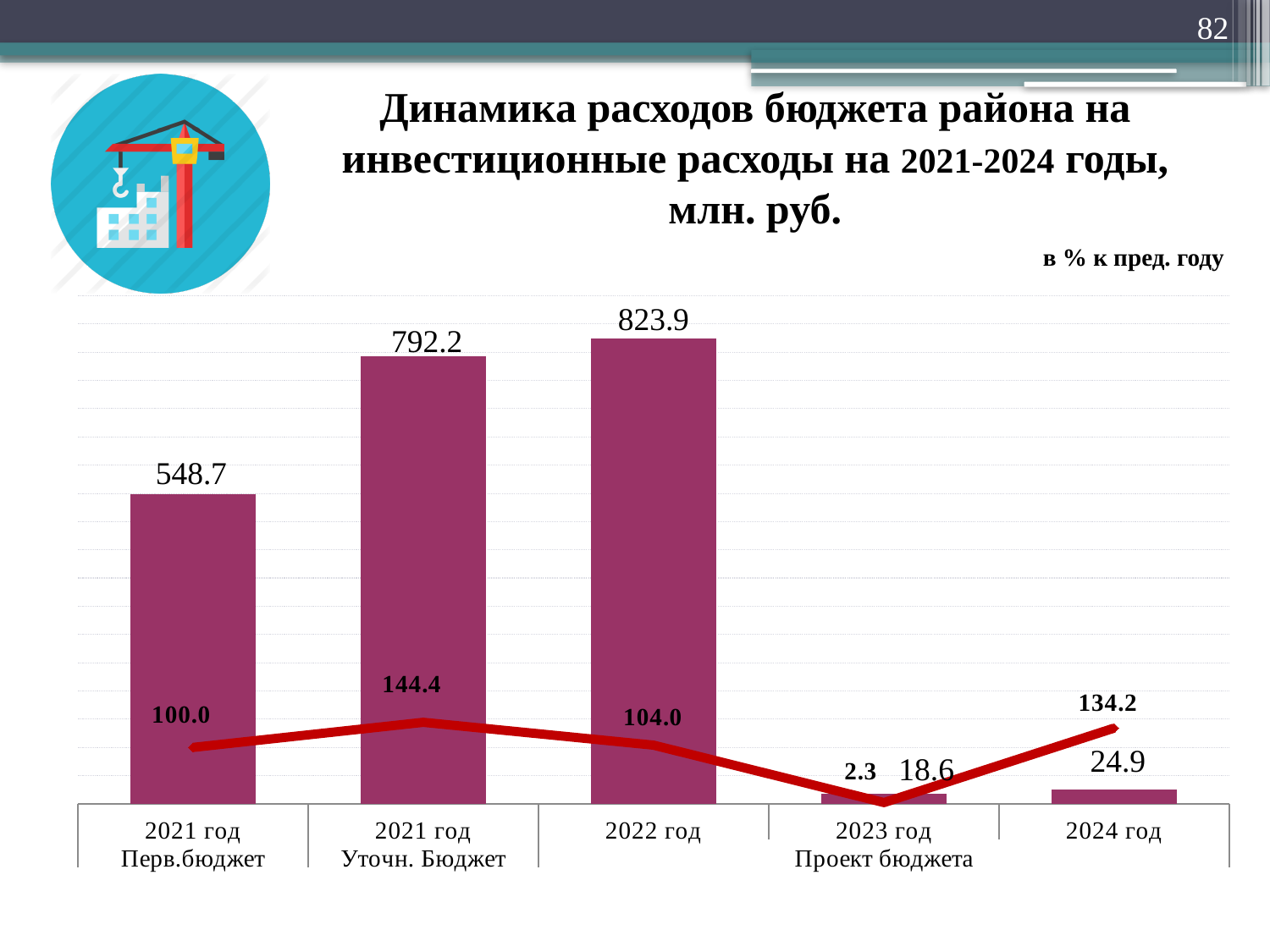
What is the value of the bar for 2021 год Перв.бюджет? 548.7 How many categories are shown on the x axis? 5 What is the value of the bar for 2024 год? 24.9 What percentage to the previous year is shown on the line for 2021 год Уточн. Бюджет? 144.4 Which category has the lowest bar value? 2023 год What percentage to the previous year (в % к пред. году) is shown on the line for 2023 год? 2.3 Which category has the highest bar value? 2022 год What is the difference between the bar values for 2022 год and 2021 год Уточн. Бюджет? 31.7 Which is larger, the bar value for 2024 год or for 2023 год? 2024 год What is the value of the bar for 2021 год Уточн. Бюджет? 792.2 What kind of chart is shown on the slide? Combined bar and line chart What is the investment expenditure value shown for 2022 год? 823.9